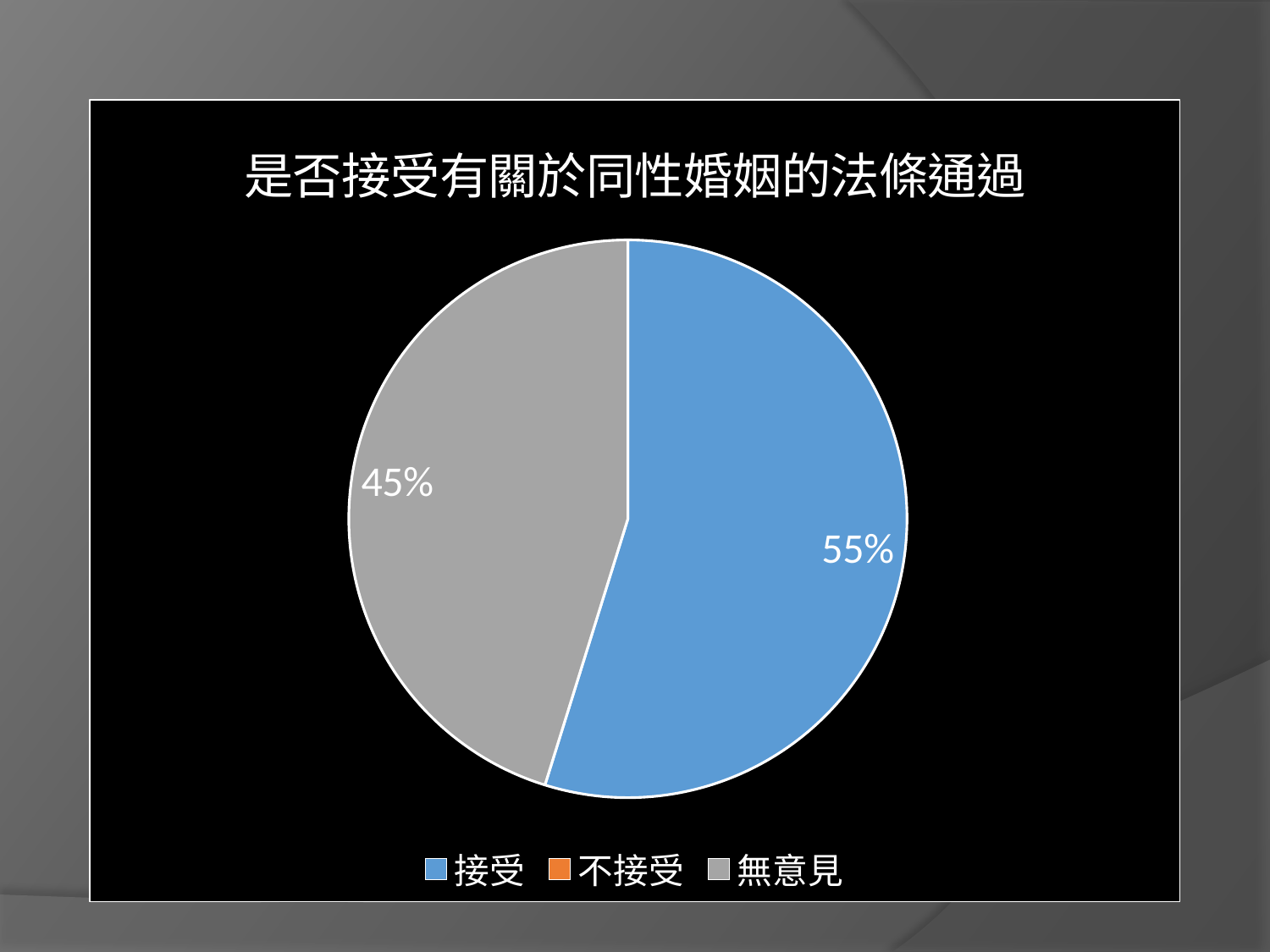
Which of 接受 or 無意見 has the larger share? 接受 How many entries does the legend list? 3 What is the title of the chart? 是否接受有關於同性婚姻的法條通過 What is the difference in percentage points between the 接受 and 無意見 slices? 10% What percentage of the pie is labelled for 無意見? 45% What kind of chart is shown on the slide? pie chart What percentage of the pie is labelled for 接受? 55% Which category has the largest share of the pie? 接受 Is the share for 接受 greater or less than 50%? greater What colour is the 接受 slice? blue Is the share for 無意見 greater or less than 50%? less How many slices with printed labels are visible in the pie? 2